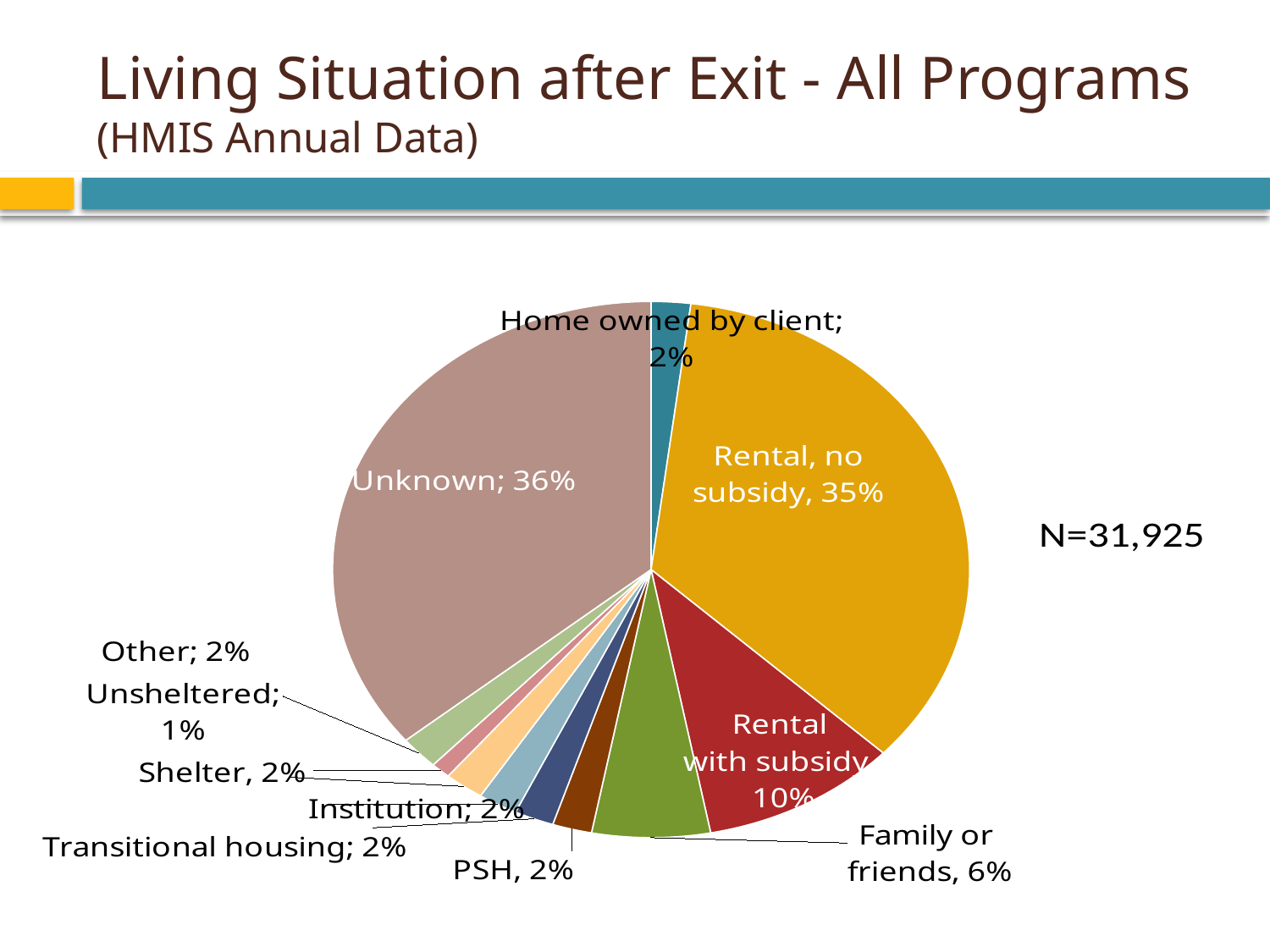
What is the N value shown next to the pie chart? N=31,925 Which category has the smallest share of the pie? Unsheltered What percentage is shown for Rental, no subsidy? 35% What percentage is shown for Rental with subsidy? 10% Which is larger, the share for Rental with subsidy or the share for Family or friends? Rental with subsidy What percentage is shown for Unsheltered? 1% What percentage is shown for Family or friends? 6% What share of the pie is labelled Unknown? 36% How many percentage points larger is Rental, no subsidy than Rental with subsidy? 25% Which category has the largest share of the pie? Unknown What kind of chart is shown on the slide? pie chart How many slices does the pie chart have? 11